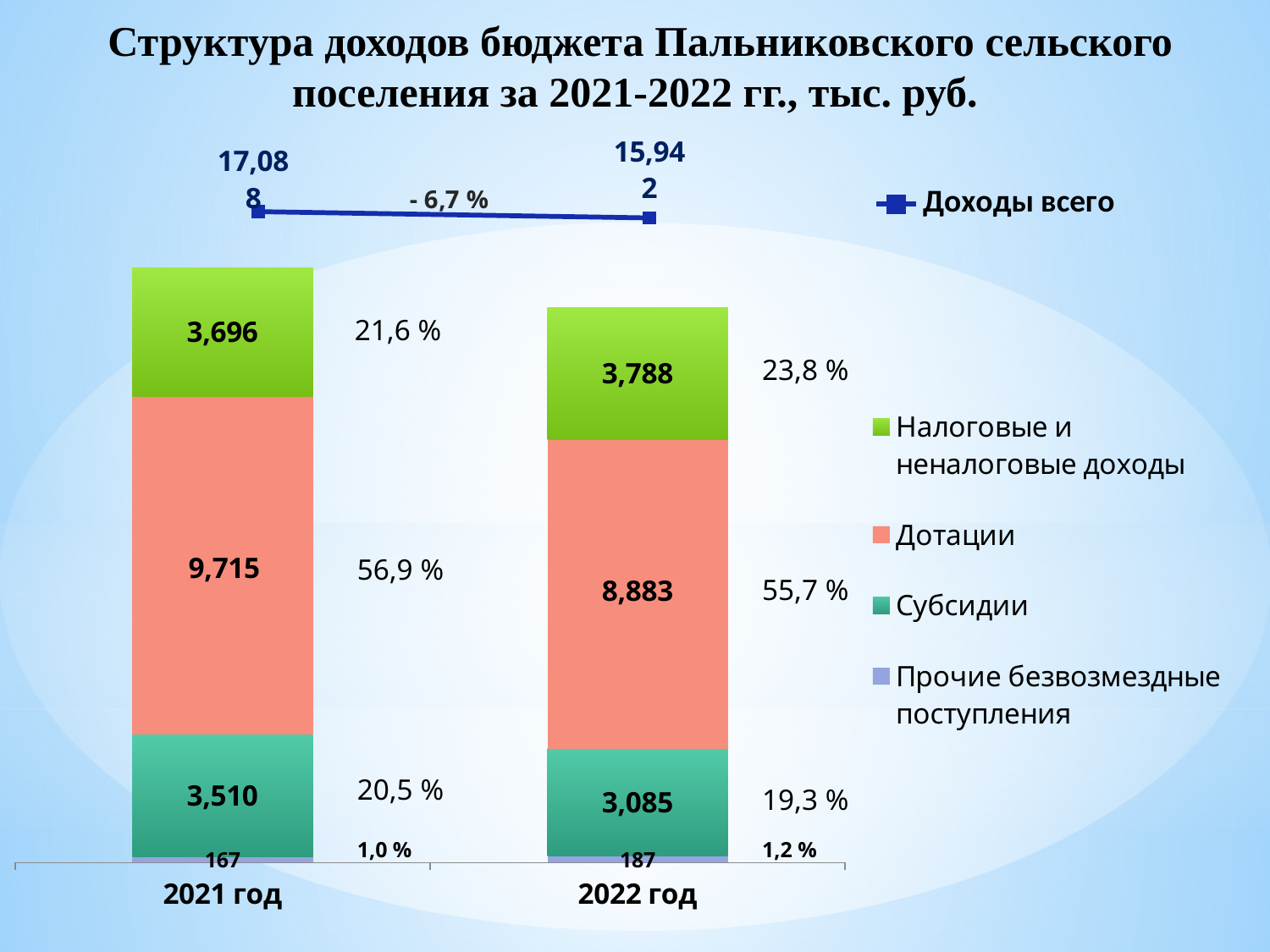
What is the total income (Доходы всего) shown for 2021 год? 17,088 Which series is the largest component of the 2022 год bar? Дотации By how much did Дотации decrease from 2021 год to 2022 год? 832 What share of the 2022 год total do Субсидии make up, as printed on the slide? 19,3 % What is the value of Налоговые и неналоговые доходы for 2022 год? 3,788 What is the value of Дотации for 2021 год? 9,715 Which year has the larger value for Субсидии, 2021 год or 2022 год? 2021 год What kind of chart is used to show the income structure? Stacked bar chart What is the total income (Доходы всего) shown for 2022 год? 15,942 What percentage change in total income between 2021 and 2022 is printed on the slide? - 6,7 % What is the value of Прочие безвозмездные поступления for 2021 год? 167 Which series is the smallest component of the 2021 год bar? Прочие безвозмездные поступления